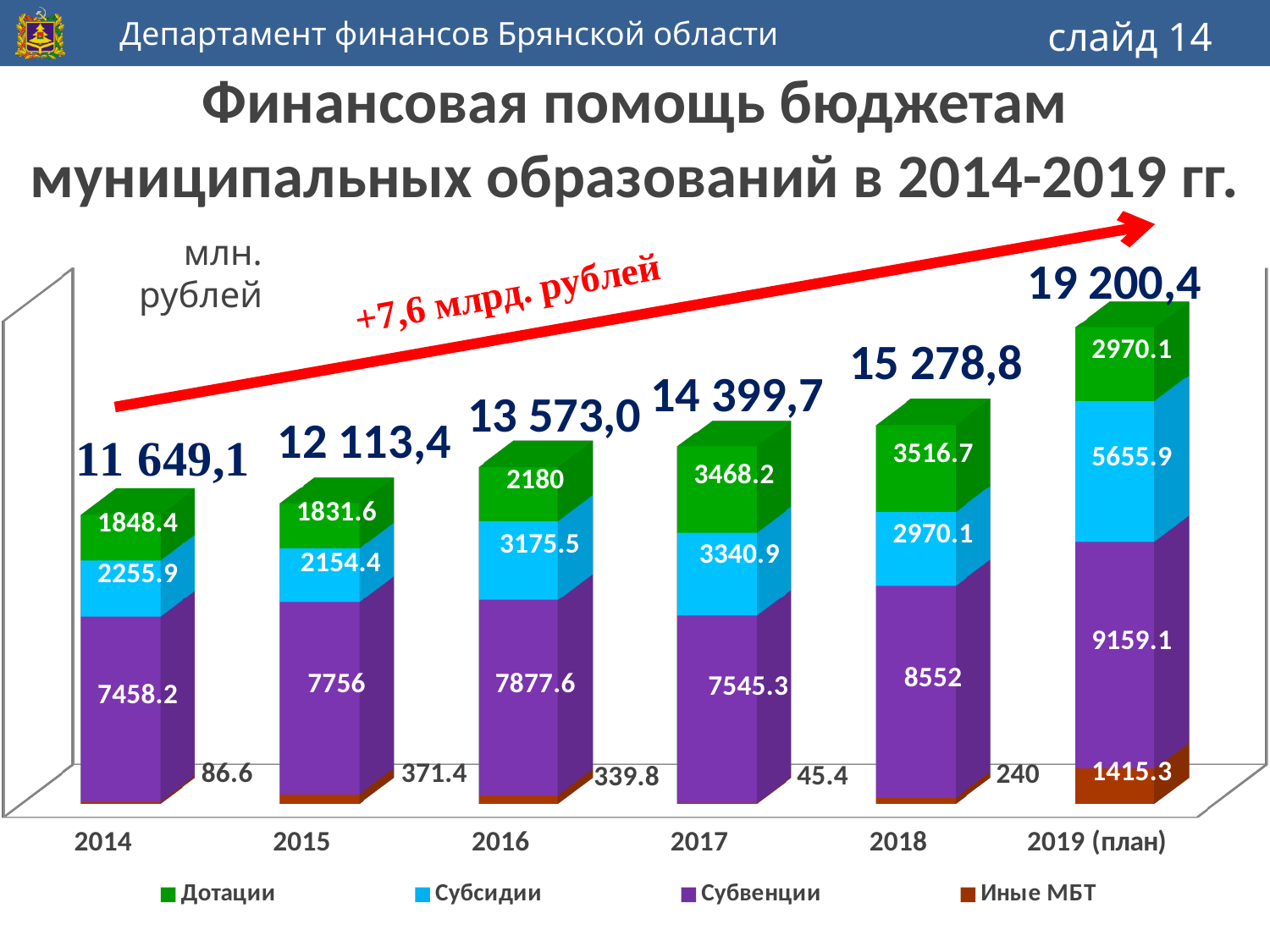
Which is larger, the Субсидии value for 2017 or for 2016? 2017 How many years are shown on the x axis? 6 Do the bar totals rise or fall from 2014 to 2019 (план)? rise In which year is the value for Иные МБТ the lowest? 2017 Which year has the highest total financial assistance? 2019 (план) What is the difference between the Субвенции values for 2019 (план) and 2018? 607.1 What is the value for Субвенции in 2018? 8552 What is the value for Субсидии in 2016? 3175.5 How many series does the legend list? 4 What is the value for Дотации in 2019 (план)? 2970.1 What is the value for Иные МБТ in 2017? 45.4 What is the total of the stacked bar for 2019 (план)? 19 200,4